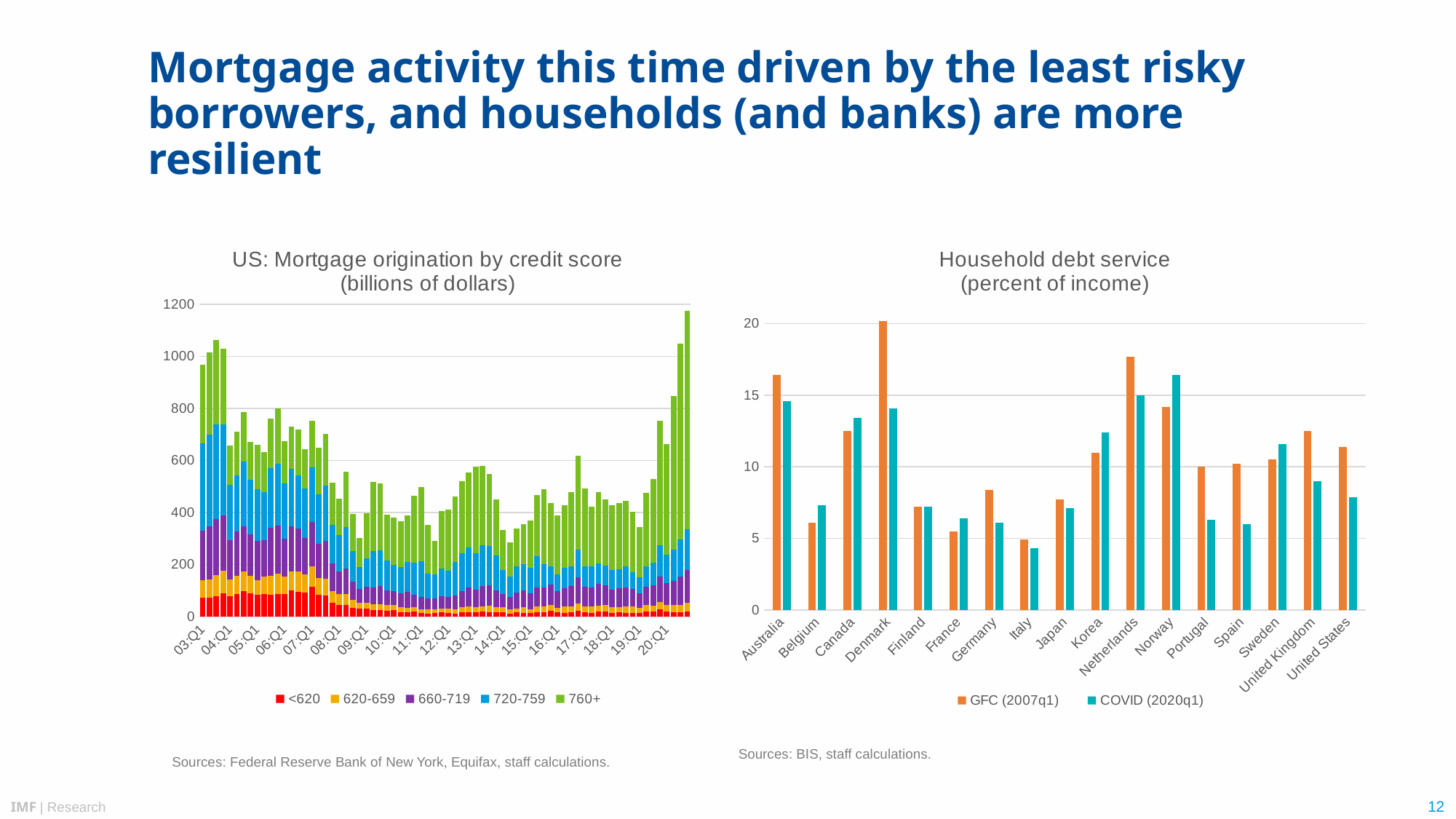
In the 'Household debt service (percent of income)' chart, which country has the highest COVID (2020q1) value? Norway In the 'US: Mortgage origination by credit score' chart, which credit score category is shown in green? 760+ In the 'Household debt service (percent of income)' chart, for the United States, which is larger: the GFC (2007q1) value or the COVID (2020q1) value? GFC (2007q1) In the 'Household debt service (percent of income)' chart, for Norway, which is larger: the GFC (2007q1) value or the COVID (2020q1) value? COVID (2020q1) What kind of chart is the 'Household debt service (percent of income)' chart? bar chart How many series does the legend of the 'Household debt service (percent of income)' chart list? 2 How many countries are shown on the x axis of the 'Household debt service (percent of income)' chart? 17 In the 'Household debt service (percent of income)' chart, is the GFC (2007q1) value for Denmark greater or less than 15? greater How many series does the legend of the 'US: Mortgage origination by credit score' chart list? 5 In the 'Household debt service (percent of income)' chart, which country has the lowest COVID (2020q1) value? Italy In the 'Household debt service (percent of income)' chart, which country has the highest GFC (2007q1) value? Denmark In the 'Household debt service (percent of income)' chart, is the GFC (2007q1) value for Belgium greater or less than 10? less